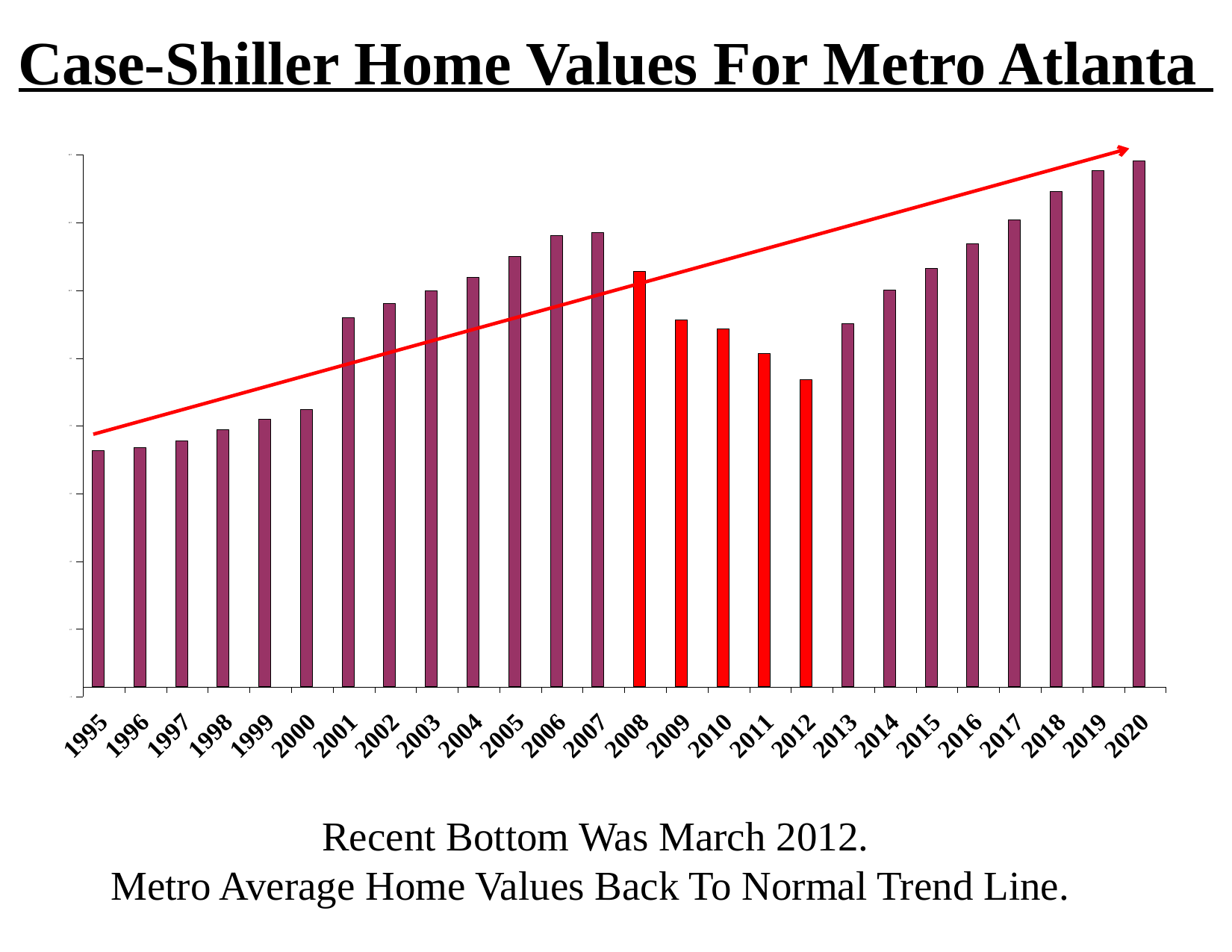
What is the title of the chart? Case-Shiller Home Values For Metro Atlanta Do the values rise or fall from 2012 to 2020? Rise Which year has the highest home value on the chart? 2020 Do the values rise or fall from 2007 to 2012? Fall How many years (bars) are plotted on the chart? 26 What kind of chart is shown on the slide? Bar chart Which year has a higher value, 2000 or 2001? 2001 Among the red bars (2008 to 2012), which year has the lowest value? 2012 Which years are shown with bright red bars? 2008 to 2012 Which year has a higher value, 2007 or 2012? 2007 Which year has a higher value, 2020 or 2007? 2020